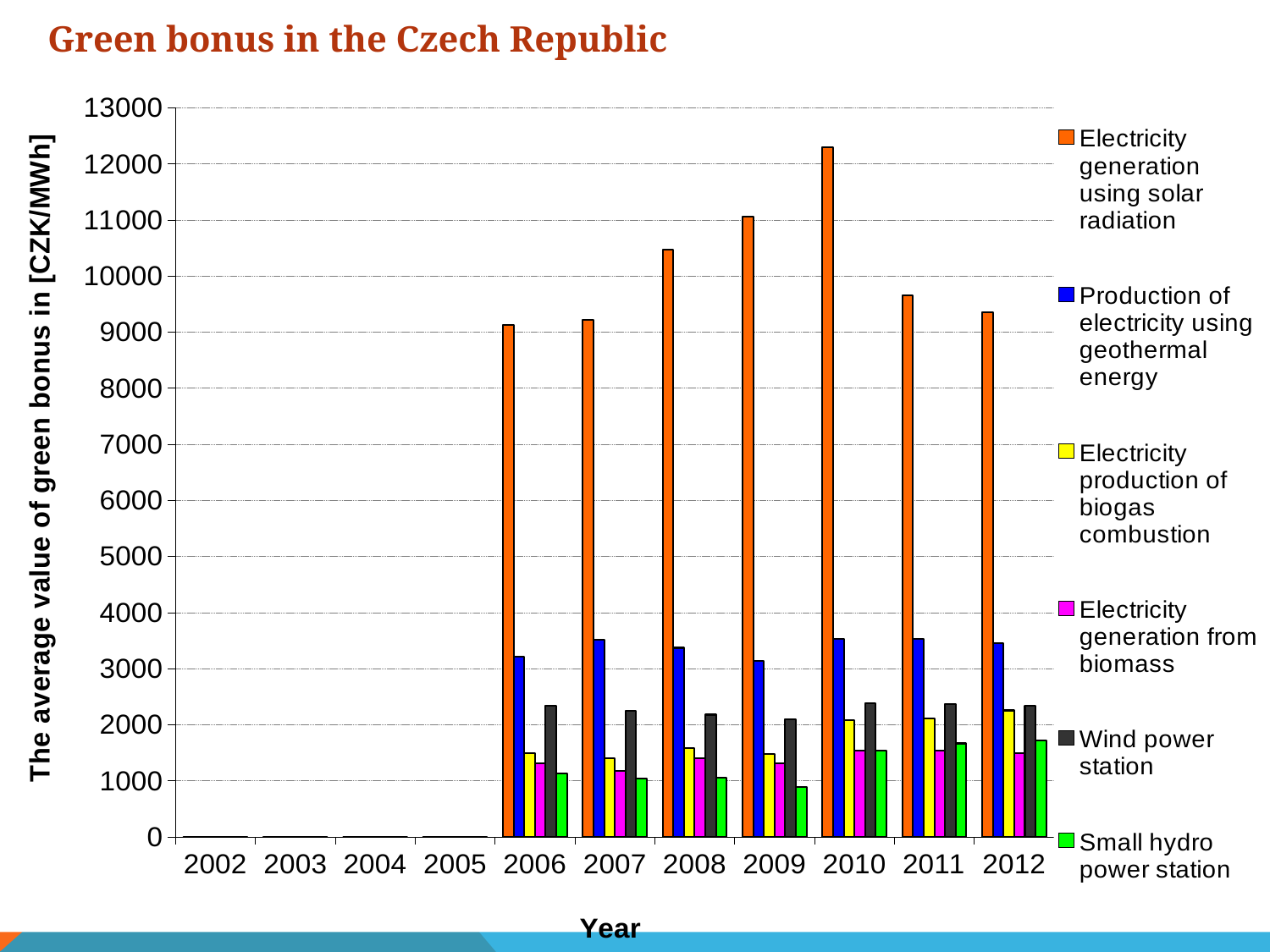
What kind of chart is shown on the slide? bar chart Which is larger in 2006, the wind power station value or the biogas combustion value? Wind power station Which is larger, the solar radiation value in 2009 or in 2011? 2009 Is the value for electricity generation using solar radiation in 2008 greater or less than 10000? greater Do the values for electricity generation using solar radiation rise or fall from 2006 to 2010? rise How many series does the legend list? 6 How many years are shown on the x axis? 11 Among the years 2006 to 2012, in which year is the small hydro power station bar the lowest? 2009 Is the value for production of electricity using geothermal energy in 2007 greater or less than 3000? greater In which year is the bar for electricity generation using solar radiation the highest? 2010 Is the value for electricity generation using solar radiation in 2010 greater or less than 12000? greater What is the label of the y axis? The average value of green bonus in [CZK/MWh]